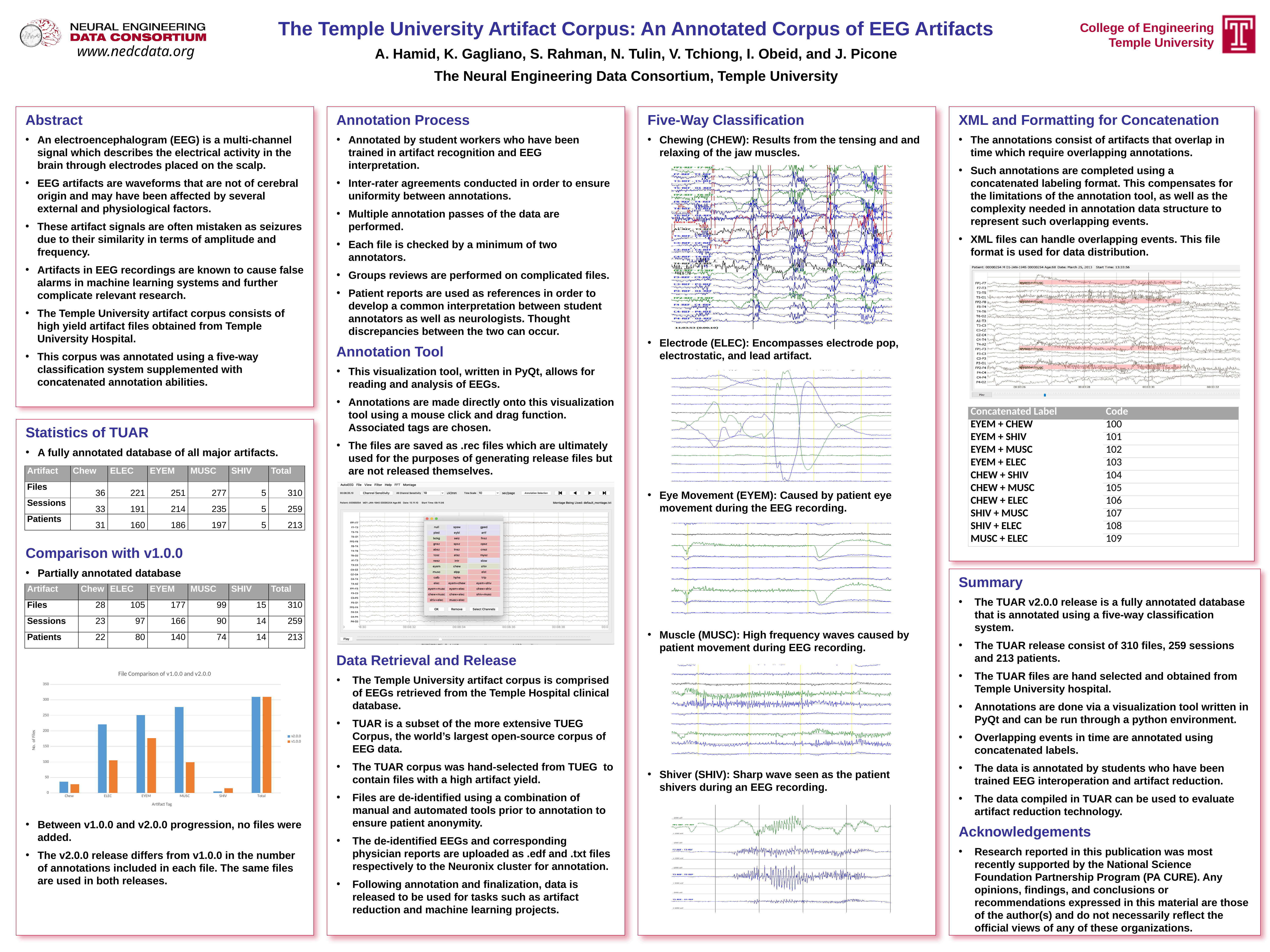
In the "File Comparison of v1.0.0 and v2.0.0" chart, which is larger for SHIV, the v2.0.0 bar or the v1.0.0 bar? v1.0.0 How many categories are shown on the x axis of the "File Comparison of v1.0.0 and v2.0.0" chart? 6 In the "File Comparison of v1.0.0 and v2.0.0" chart, is the v2.0.0 value for MUSC greater or less than 250? greater In the "File Comparison of v1.0.0 and v2.0.0" chart, which category has the highest v2.0.0 bar? Total How many series does the legend of the "File Comparison of v1.0.0 and v2.0.0" chart list? 2 What is the x-axis label of the "File Comparison of v1.0.0 and v2.0.0" chart? Artifact Tag In the "File Comparison of v1.0.0 and v2.0.0" chart, which is larger for ELEC, the v2.0.0 bar or the v1.0.0 bar? v2.0.0 In the "File Comparison of v1.0.0 and v2.0.0" chart, is the v2.0.0 value for Chew greater or less than 50? less In the "File Comparison of v1.0.0 and v2.0.0" chart, is the v2.0.0 value for ELEC greater or less than 200? greater What kind of chart is the "File Comparison of v1.0.0 and v2.0.0" chart? bar chart In the "File Comparison of v1.0.0 and v2.0.0" chart, which category has the lowest v2.0.0 bar? SHIV